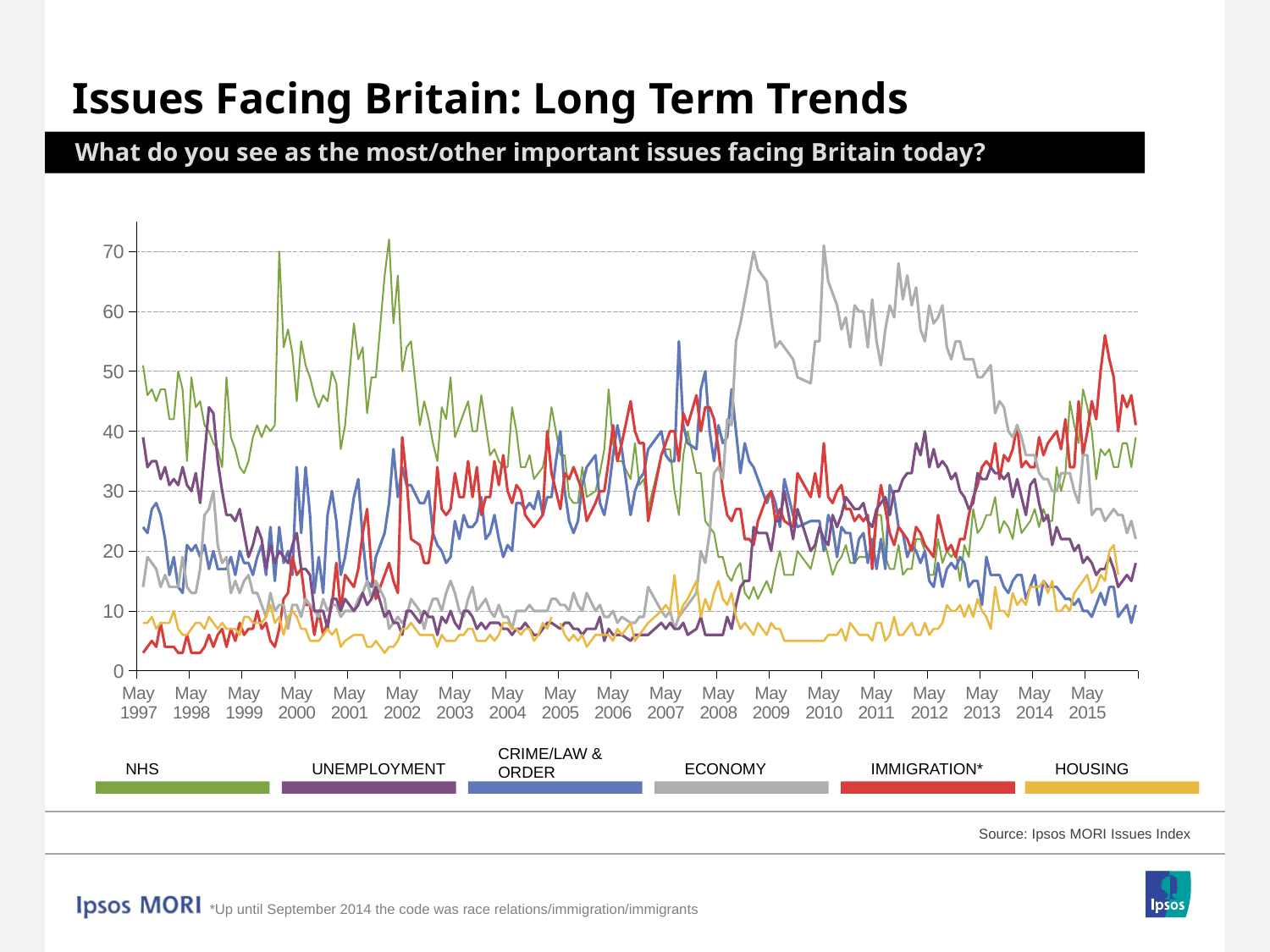
What kind of chart is shown on the slide? line chart Is the value for ECONOMY around May 2005 greater or less than 20? less Does the ECONOMY series rise or fall between May 2010 and May 2015? fall Which series has the highest value around May 2002? NHS Is the value for IMMIGRATION* at May 1997 greater or less than 10? less Which series is plotted in red? IMMIGRATION* Is the value for ECONOMY around May 2010 greater or less than 60? greater What is the source cited below the chart? Ipsos MORI Issues Index Which series has the lowest value around May 2010? HOUSING Around May 2010, which is larger: ECONOMY or HOUSING? ECONOMY Which series has the highest value around May 2010? ECONOMY How many series does the legend list? 6